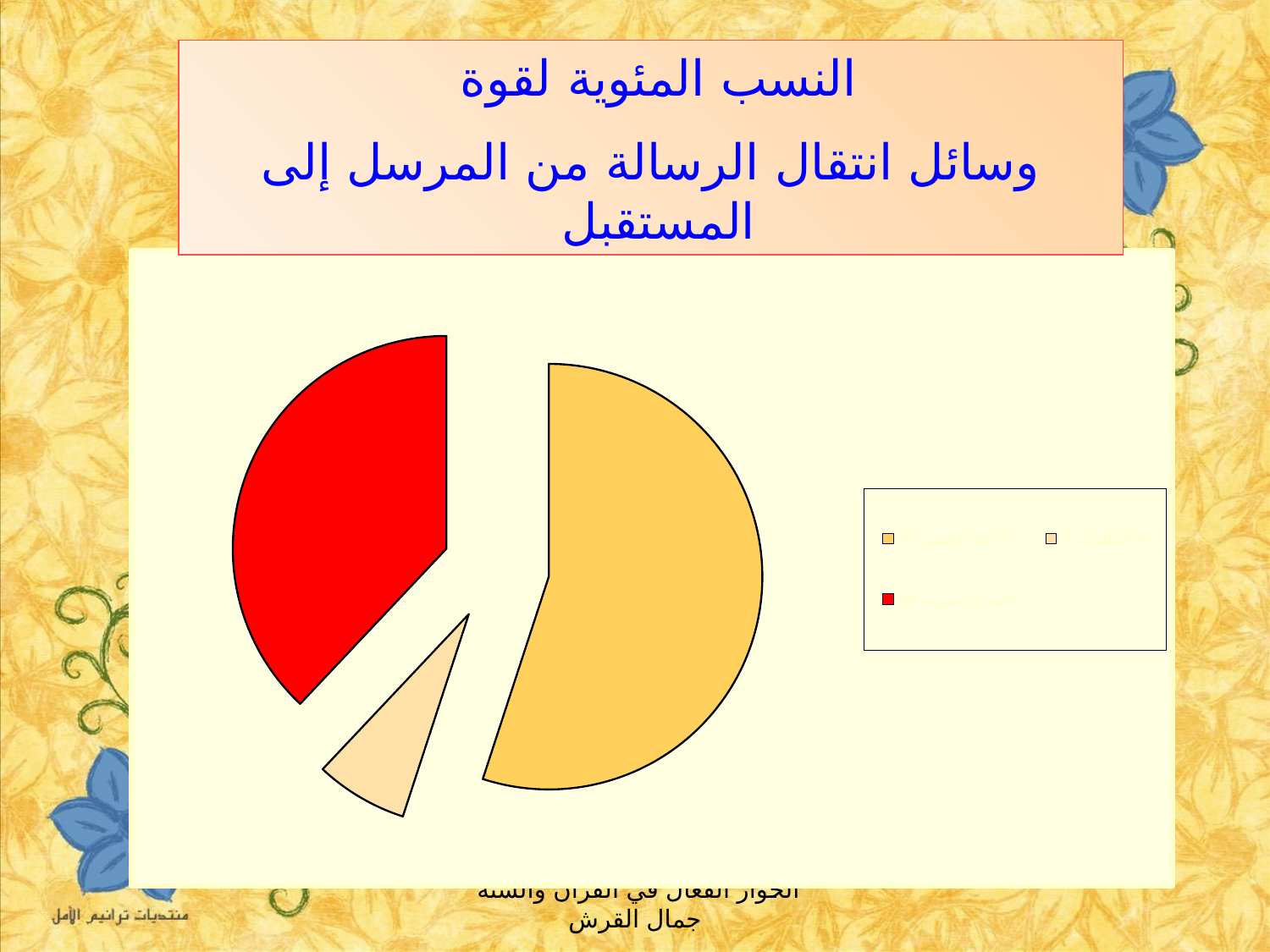
On which side of the pie chart is the legend placed? right Is the light peach slice's share of the pie greater or less than 25%? less How many entries does the legend of the pie chart list? 3 How many slices does the pie chart have? 3 What is the title shown above the pie chart? النسب المئوية لقوة وسائل انتقال الرسالة من المرسل إلى المستقبل Which is larger in the pie chart, the red slice or the light peach slice? the red slice Which is larger in the pie chart, the yellow slice or the red slice? the yellow slice What kind of chart is shown on the slide? pie chart Which colour slice is the smallest in the pie chart? light peach Which colour slice is the largest in the pie chart? yellow Is the yellow slice's share of the pie greater or less than 50%? greater